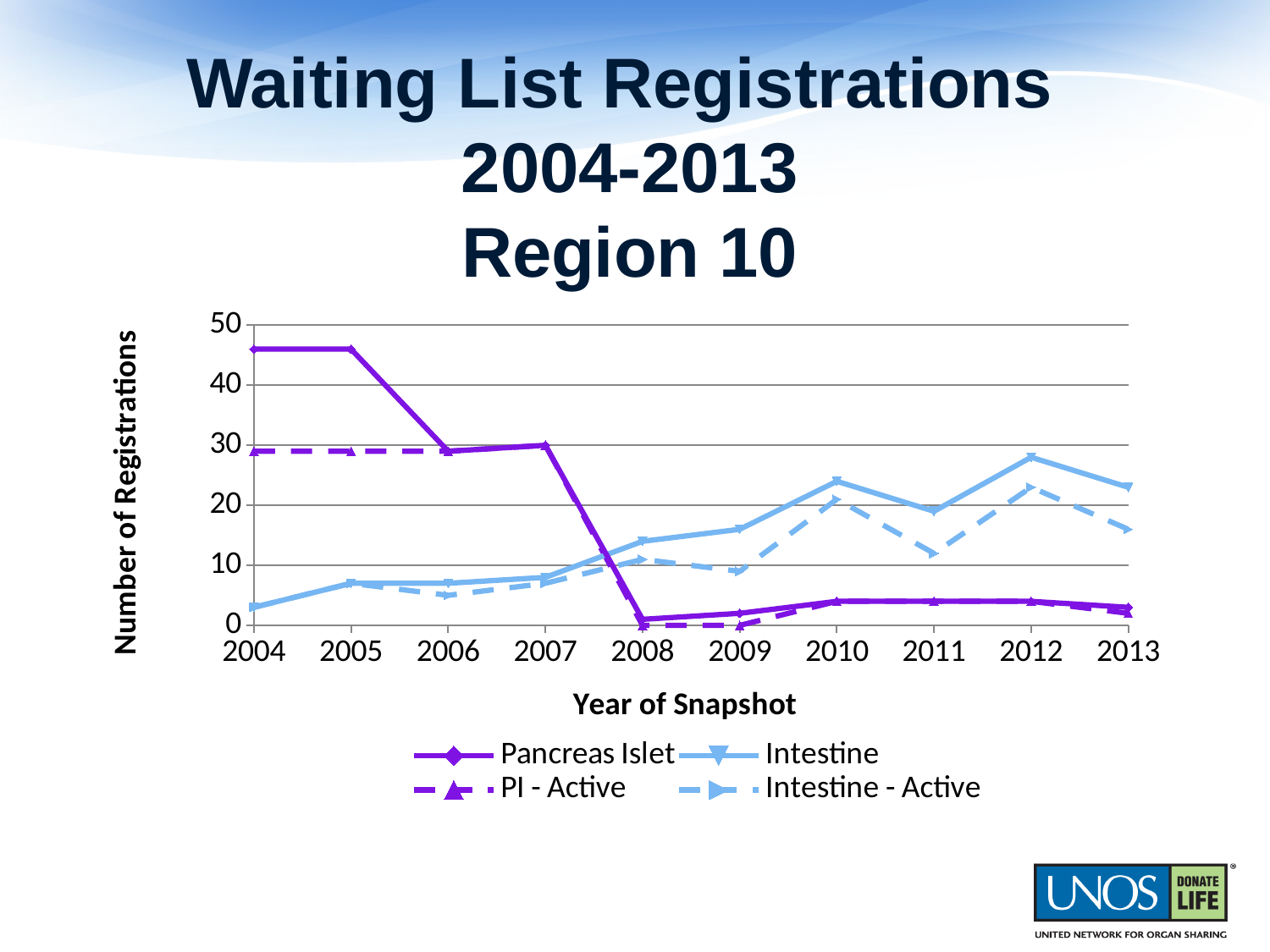
What kind of chart is shown on the slide? line chart How many years are shown on the x axis? 10 Is the value for Intestine in 2012 greater or less than 20? greater In 2010, which series has the larger value, Intestine or Pancreas Islet? Intestine Is the value for Intestine in 2004 greater or less than 10? less In which year does the Intestine series reach its highest value? 2012 What is the title of the y axis? Number of Registrations How many series does the legend list? 4 Does the Pancreas Islet series rise or fall overall from 2004 to 2013? fall What is the title of the x axis? Year of Snapshot Is the value for Pancreas Islet in 2004 greater or less than 40? greater